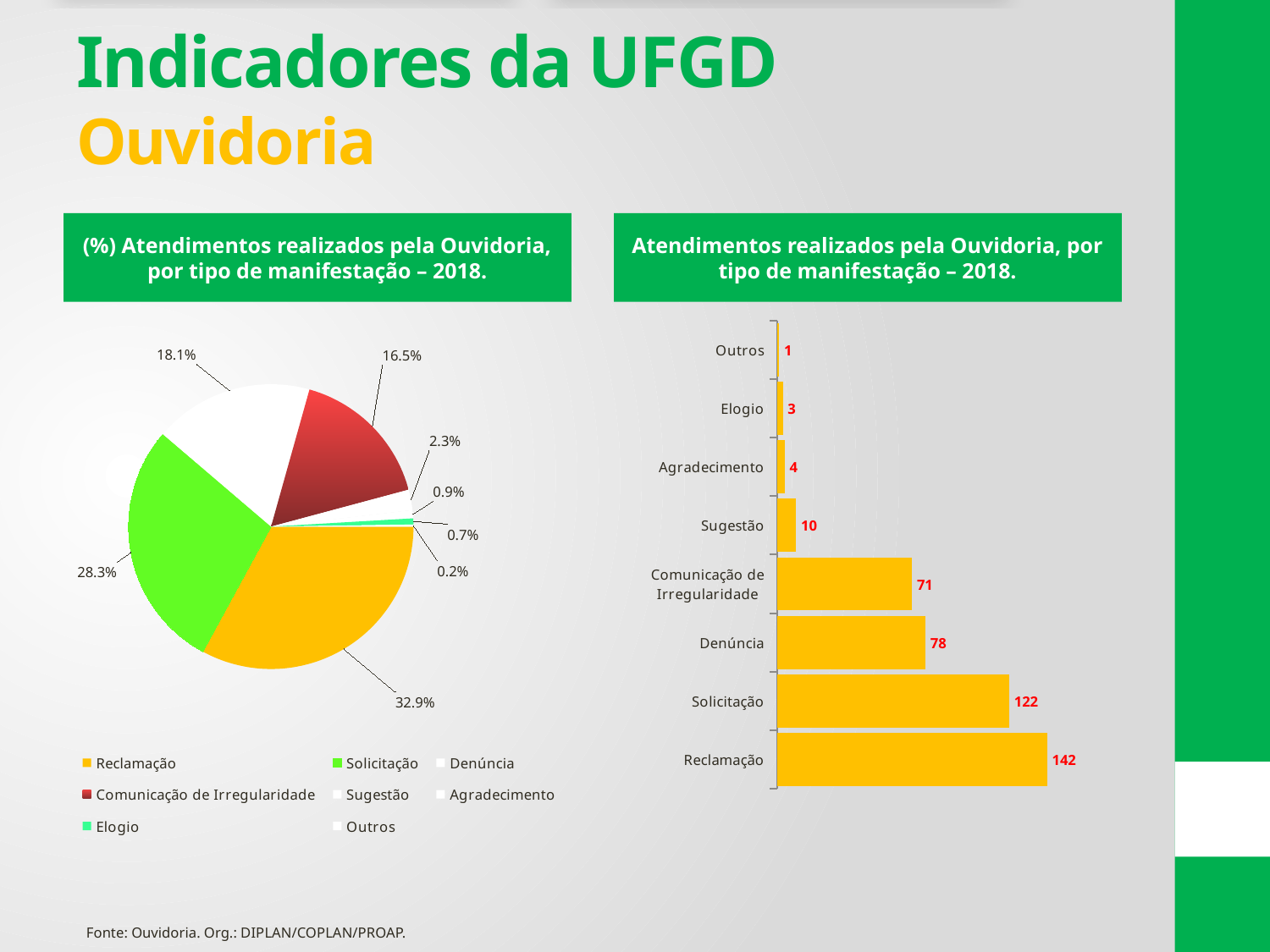
In the bar chart 'Atendimentos realizados pela Ouvidoria, por tipo de manifestação – 2018', which is larger, Denúncia or Comunicação de Irregularidade? Denúncia How many categories are shown in the bar chart 'Atendimentos realizados pela Ouvidoria, por tipo de manifestação – 2018'? 8 In the bar chart 'Atendimentos realizados pela Ouvidoria, por tipo de manifestação – 2018', what is the value for Sugestão? 10 In the bar chart 'Atendimentos realizados pela Ouvidoria, por tipo de manifestação – 2018', which category has the highest value? Reclamação In the pie chart '(%) Atendimentos realizados pela Ouvidoria, por tipo de manifestação – 2018', what share does Solicitação have? 28.3% In the pie chart '(%) Atendimentos realizados pela Ouvidoria, por tipo de manifestação – 2018', what share does Reclamação have? 32.9% In the bar chart 'Atendimentos realizados pela Ouvidoria, por tipo de manifestação – 2018', what is the value for Comunicação de Irregularidade? 71 What kind of chart is the chart on the right of the slide? Bar chart In the bar chart 'Atendimentos realizados pela Ouvidoria, por tipo de manifestação – 2018', what is the difference between Solicitação and Denúncia? 44 In the bar chart 'Atendimentos realizados pela Ouvidoria, por tipo de manifestação – 2018', what is the value for Reclamação? 142 How many entries does the legend of the pie chart '(%) Atendimentos realizados pela Ouvidoria, por tipo de manifestação – 2018' list? 8 In the bar chart 'Atendimentos realizados pela Ouvidoria, por tipo de manifestação – 2018', which category has the lowest value? Outros